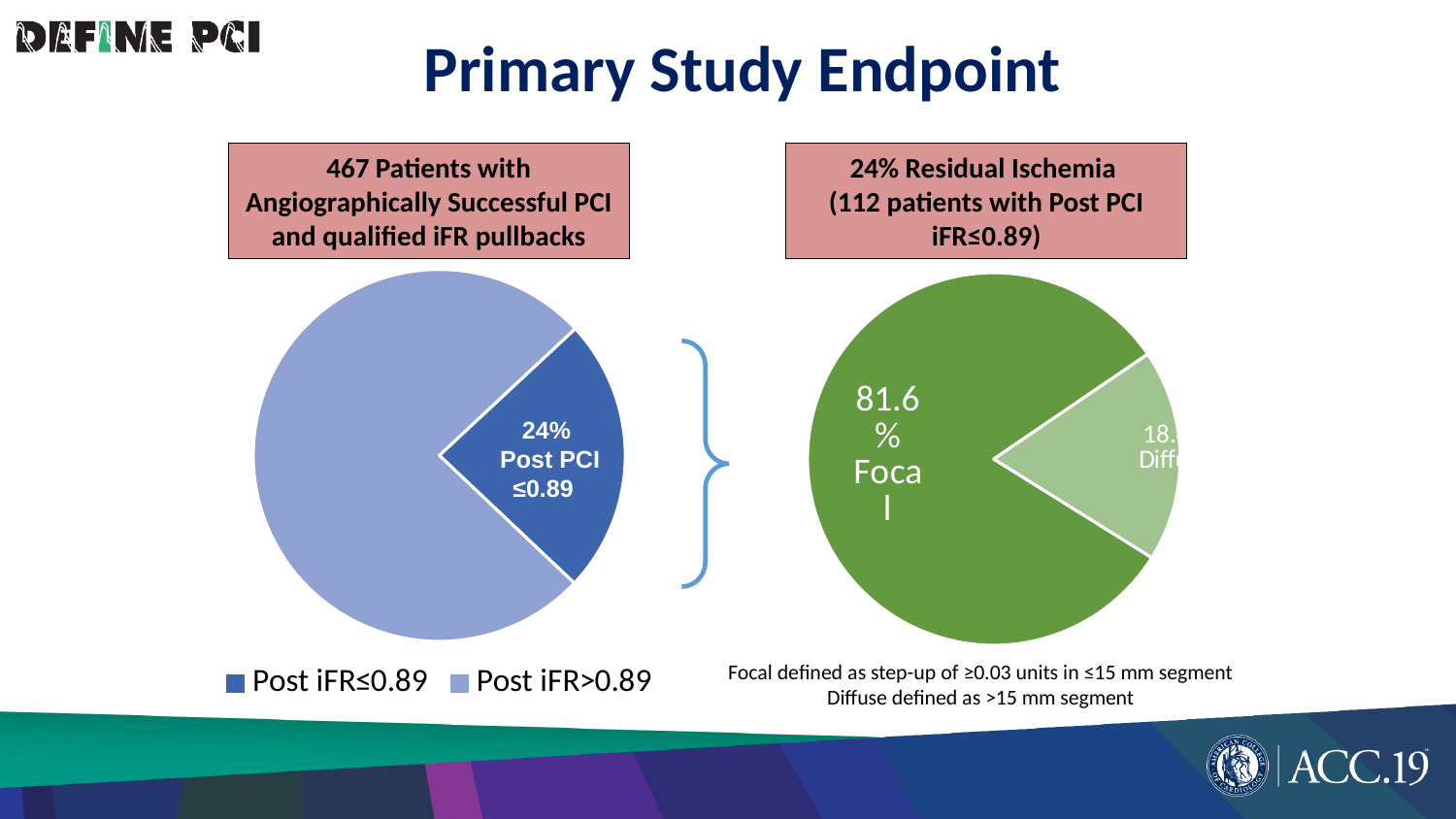
How many entries does the legend below the left pie chart list? 2 How many slices does the right pie chart have? 2 In the right pie chart, which slice is larger: Focal or Diffuse? Focal In the left pie chart, what colour is the Post iFR≤0.89 slice? dark blue In the right pie chart, which category has the largest slice? Focal How many slices does the left pie chart have? 2 In the left pie chart, what share of the pie is the Post PCI ≤0.89 slice? 24% In the right pie chart, what share of the pie is the Focal slice? 81.6% In the left pie chart, which category has the smallest slice? Post iFR≤0.89 What kind of chart is the right chart on the slide? pie chart What kind of chart is the left chart on the slide? pie chart In the left pie chart, which slice is larger: Post iFR≤0.89 or Post iFR>0.89? Post iFR>0.89